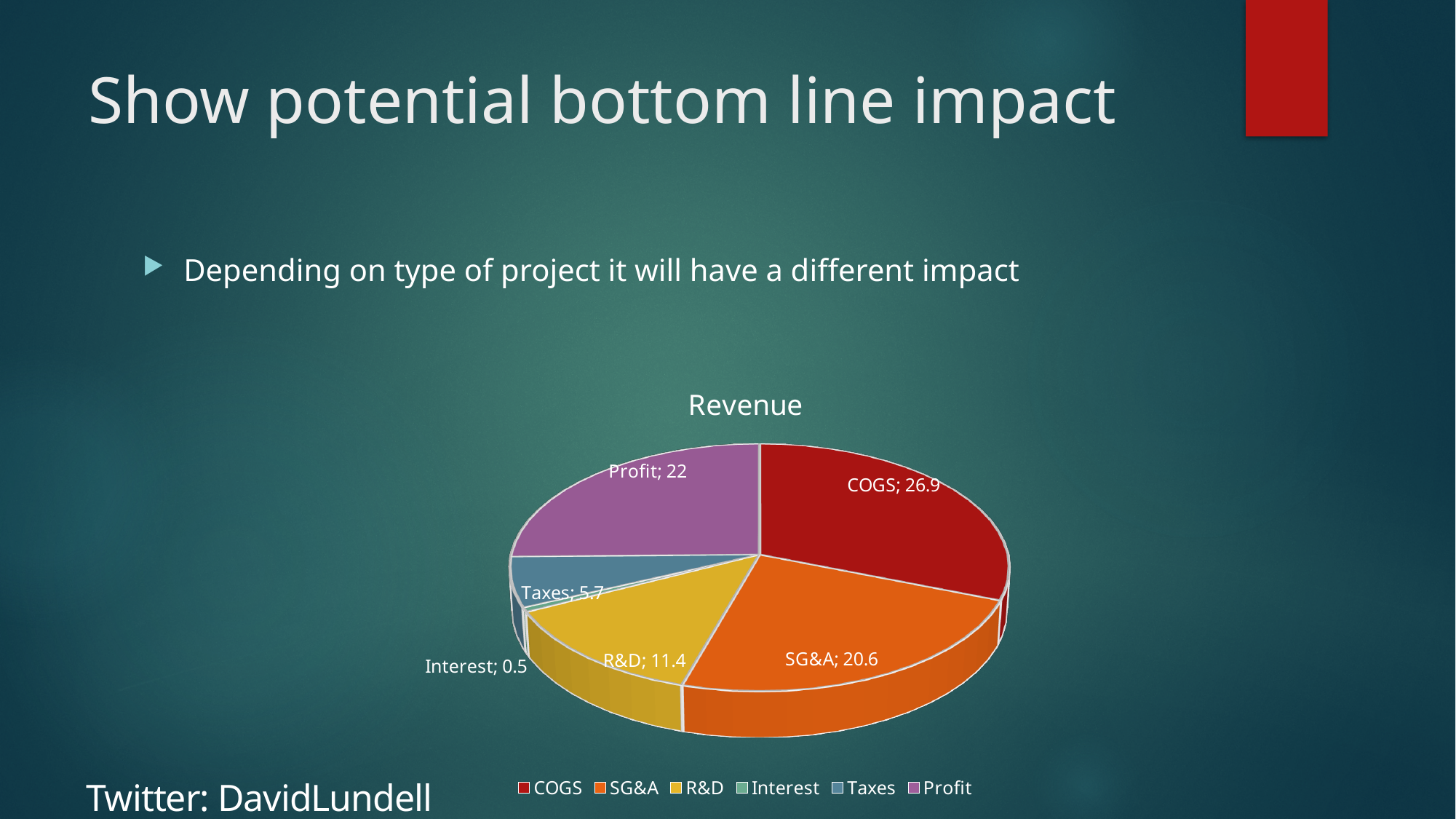
What is the value shown for Interest in the Revenue pie chart? 0.5 What is the difference between the COGS and SG&A values in the Revenue pie chart? 6.3 Which slice of the Revenue pie chart has the largest value? COGS How many slices does the Revenue pie chart have? 6 What is the difference between the Profit and Taxes values in the Revenue pie chart? 16.3 What is the value of the Profit slice in the Revenue pie chart? 22 How many entries does the legend of the Revenue chart list? 6 In the Revenue pie chart, which is larger: R&D or Taxes? R&D What is the title of the chart on the slide? Revenue Which slice of the Revenue pie chart has the smallest value? Interest What is the value of the COGS slice in the Revenue pie chart? 26.9 What kind of chart is shown on the slide? Pie chart